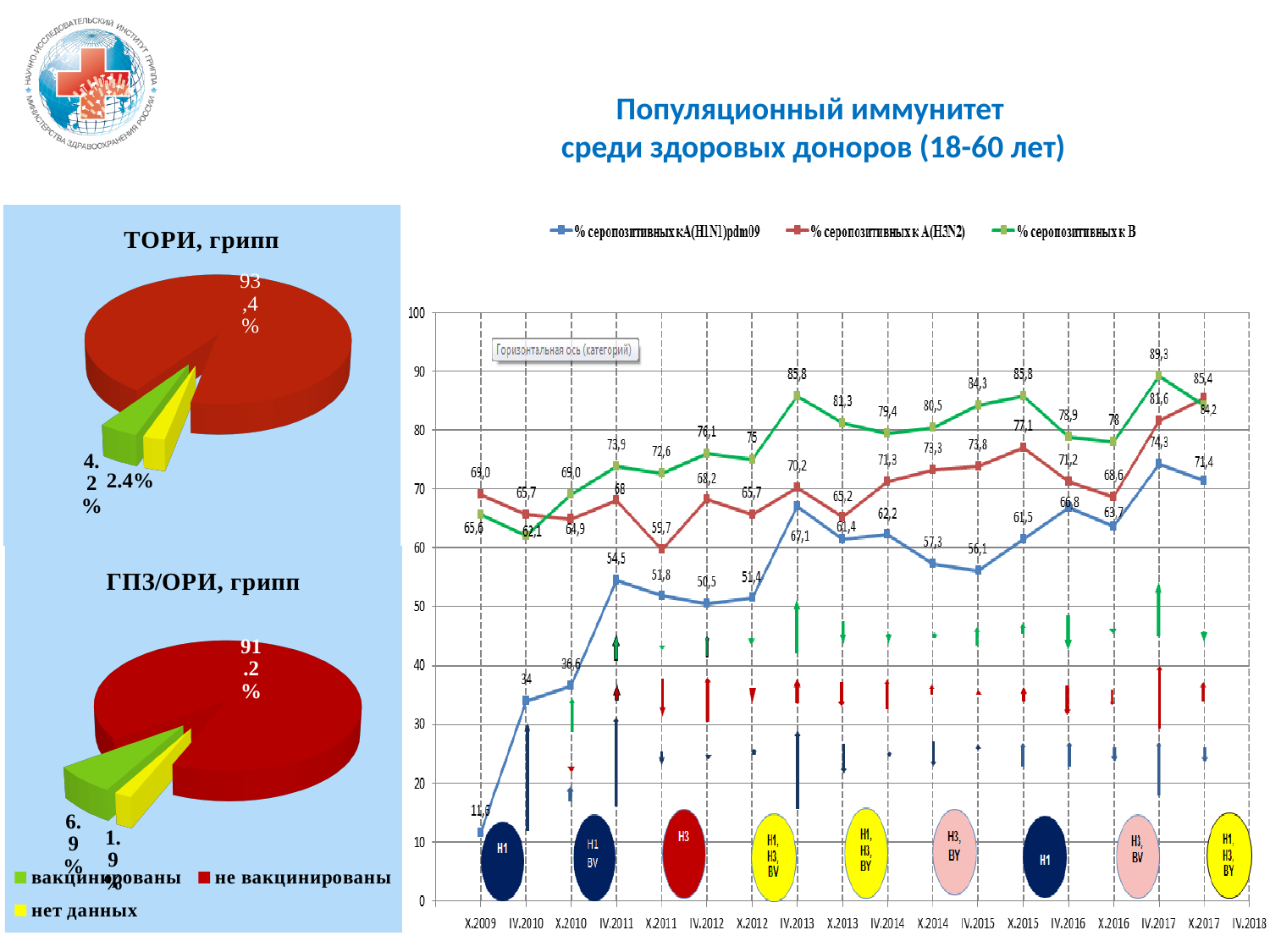
In the "ГПЗ/ОРИ, грипп" pie chart, what share is shown for "нет данных"? 1.9% What kind of chart is the large chart on the right of the slide? line chart In the line chart on the right, what is the difference between "% серопозитивных к B" and "% серопозитивных к A(H1N1)pdm09" at X.2009? 54,1 In the "ТОРИ, грипп" pie chart, which slice is the largest? не вакцинированы In the "ГПЗ/ОРИ, грипп" pie chart, what share is shown for "вакцинированы"? 6.9% In the line chart on the right, at which time point does "% серопозитивных к A(H1N1)pdm09" reach its lowest value? X.2009 In the line chart on the right, what is the value of "% серопозитивных к A(H1N1)pdm09" at X.2009? 11,5 In the "ТОРИ, грипп" pie chart, what share is labelled for the "не вакцинированы" slice? 93,4% What kind of chart is the "ТОРИ, грипп" chart on the left? pie chart In the line chart on the right, what is the value of "% серопозитивных к B" at IV.2017? 89,3 In the line chart on the right, does "% серопозитивных к A(H1N1)pdm09" rise or fall from X.2009 to IV.2011? rise How many series does the legend of the line chart on the right list? 3